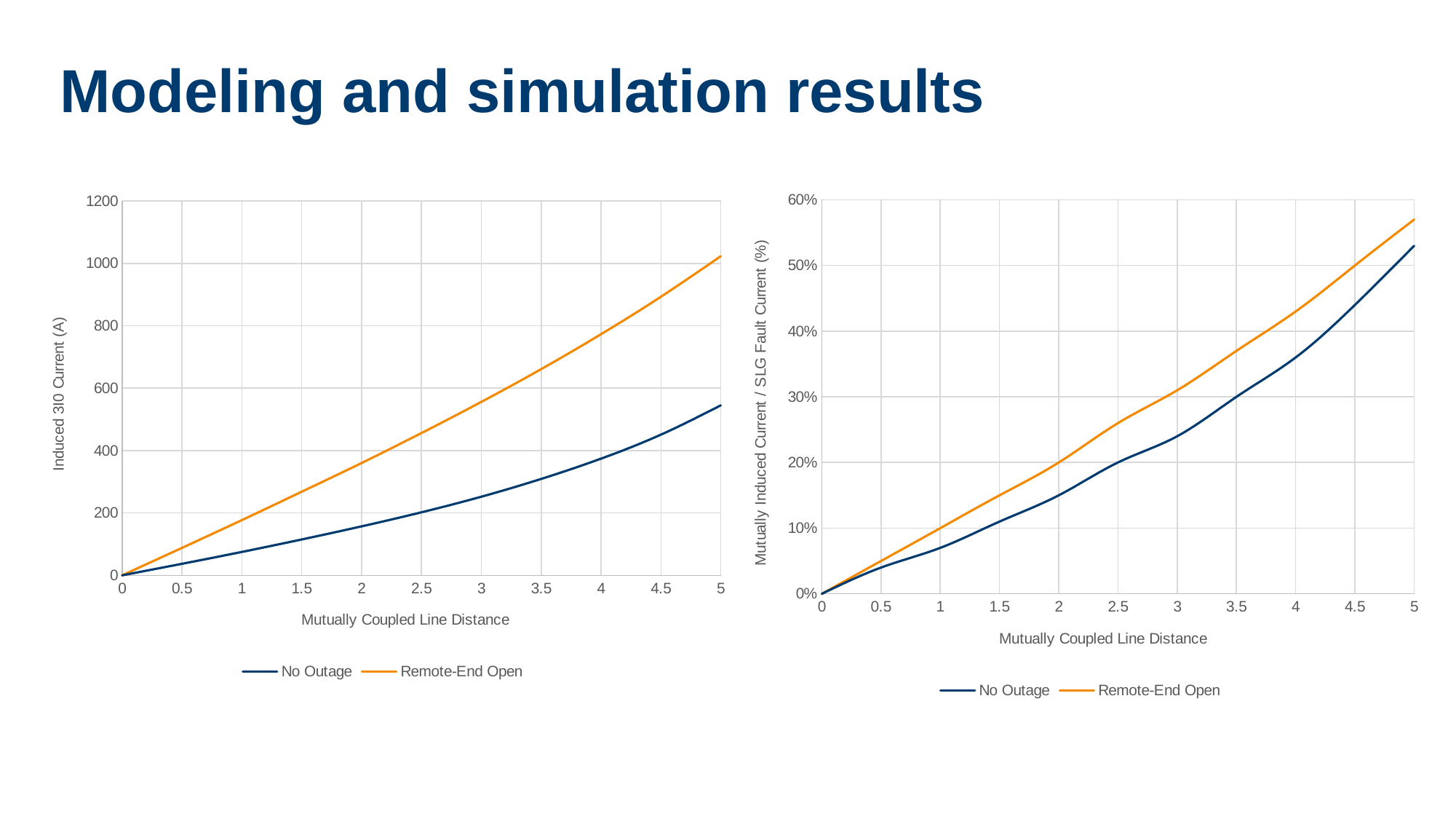
In the left chart (Induced 3I0 Current), is the value for No Outage at a distance of 5 greater or less than 600? less In the right chart (Mutually Induced Current / SLG Fault Current), is the value for No Outage at a distance of 3 greater or less than 30%? less In the left chart (Induced 3I0 Current), do the values for Remote-End Open rise or fall as Mutually Coupled Line Distance increases? rise What is the x-axis title of the left chart? Mutually Coupled Line Distance In the left chart (Induced 3I0 Current), what is the value for No Outage at a distance of 0? 0 What kind of chart is the left chart (Induced 3I0 Current)? line chart In the left chart (Induced 3I0 Current), which series is lower at a distance of 3: No Outage or Remote-End Open? No Outage How many series does the legend of the right chart (Mutually Induced Current / SLG Fault Current) list? 2 In the right chart (Mutually Induced Current / SLG Fault Current), is the value for Remote-End Open at a distance of 5 greater or less than 50%? greater What is the y-axis title of the right chart? Mutually Induced Current / SLG Fault Current (%) In the right chart (Mutually Induced Current / SLG Fault Current), which series is higher at a distance of 4: No Outage or Remote-End Open? Remote-End Open